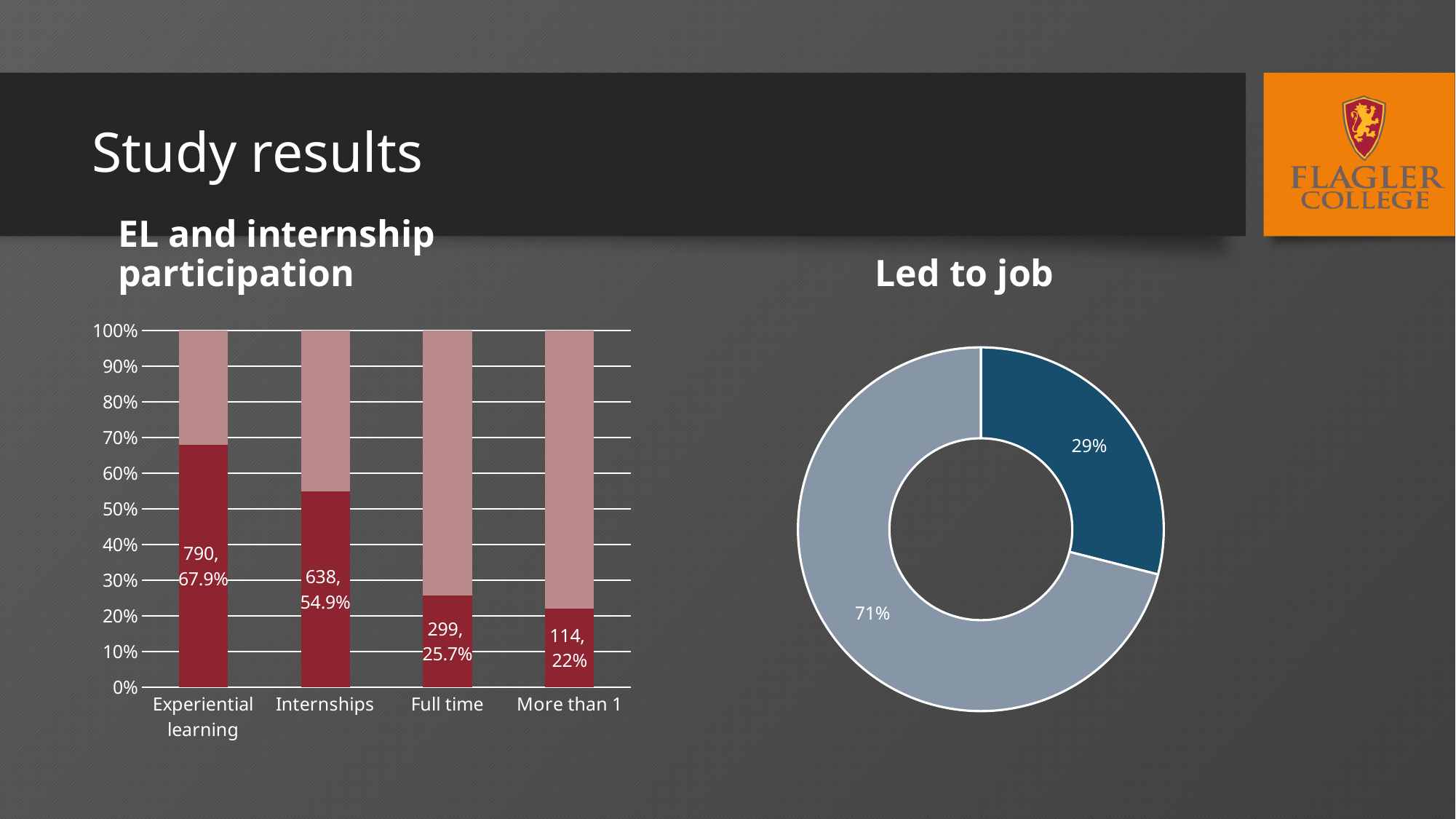
How many categories are shown on the x axis of the 'EL and internship participation' chart? 4 In the 'EL and internship participation' chart, which is larger: the percentage for Internships or for Full time? Internships In the 'EL and internship participation' chart, what is the difference between the labelled counts for Experiential learning and Internships? 152 In the 'Led to job' chart, what percentage is shown for the dark blue slice? 29% In the 'EL and internship participation' chart, what count is labelled on the 'More than 1' bar? 114 In the 'Led to job' chart, what is the larger slice's percentage? 71% In the 'EL and internship participation' chart, what percentage is shown for Full time? 25.7% In the 'EL and internship participation' chart, which category has the lowest labelled percentage? More than 1 In the 'EL and internship participation' chart, what count is labelled on the Internships bar? 638 What kind of chart is the 'EL and internship participation' chart? Stacked bar chart In the 'EL and internship participation' chart, what percentage is shown for Experiential learning? 67.9% In the 'EL and internship participation' chart, which category has the highest labelled percentage? Experiential learning